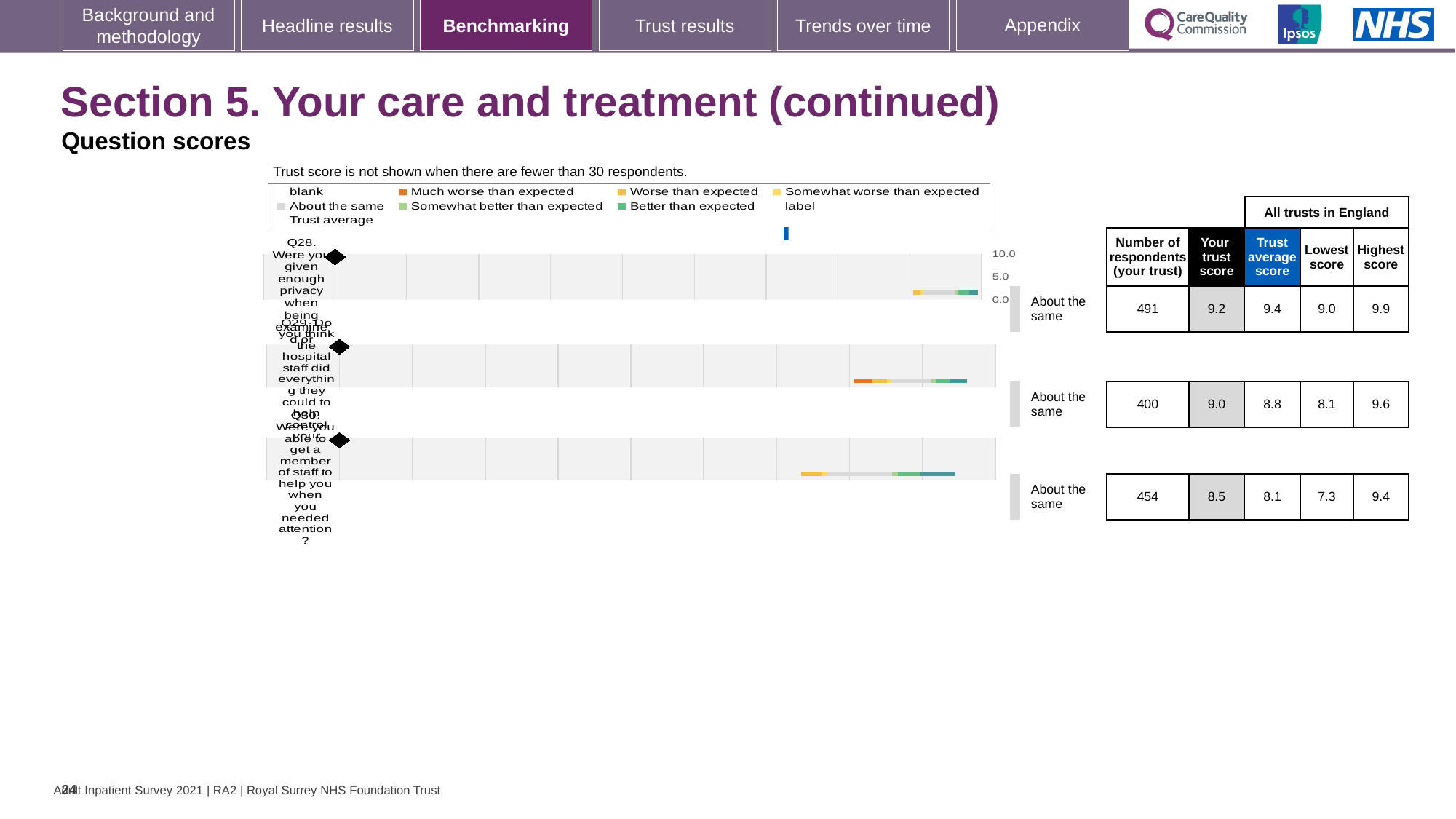
What is the difference between the trust score and the trust average score for Q30? 0.4 Which of the three questions has the lowest trust score? Q30 What is the highest value shown on the score axis of the chart? 10.0 What is the trust score for Q28 (privacy when being examined or treated)? 9.2 What is the trust score for Q29 (hospital staff did everything they could to help control pain)? 9.0 How many respondents answered Q28 at this trust? 491 Which of the three questions has the highest trust score? Q28 For Q29, which is larger: the trust score or the trust average score? the trust score How many questions (bars) are plotted in the question scores chart? 3 What kind of chart is used to show the question scores on this slide? bar chart What is the trust score for Q30 (able to get a member of staff to help when needed attention)? 8.5 What benchmark category is shown next to the Q28 bar? About the same